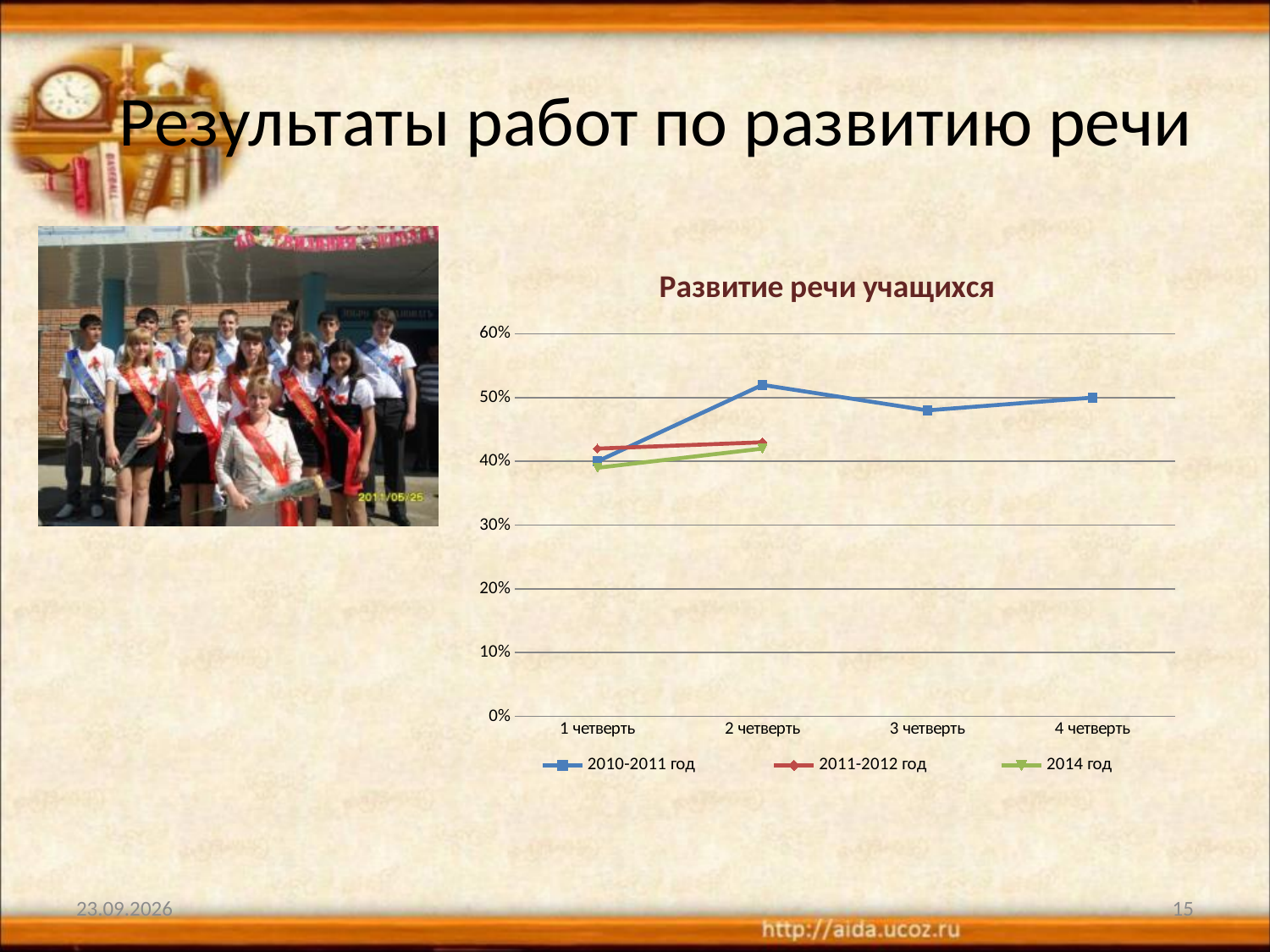
How many categories are shown on the x axis of the chart? 4 Does the 2014 год series rise or fall from 1 четверть to 2 четверть? rise Is the value for 2010-2011 год in 1 четверть greater or less than 50%? less Is the value for 2010-2011 год in 3 четверть greater or less than 50%? less Which series in the chart has data points for all four quarters? 2010-2011 год In 1 четверть, which series has the larger value: 2011-2012 год or 2014 год? 2011-2012 год For the 2010-2011 год series, in which quarter is the value lowest? 1 четверть How many series does the chart legend list? 3 For the 2010-2011 год series, in which quarter is the value highest? 2 четверть What is the title of the chart? Развитие речи учащихся Is the value for 2010-2011 год in 2 четверть greater or less than 50%? greater What kind of chart is shown on the slide? line chart